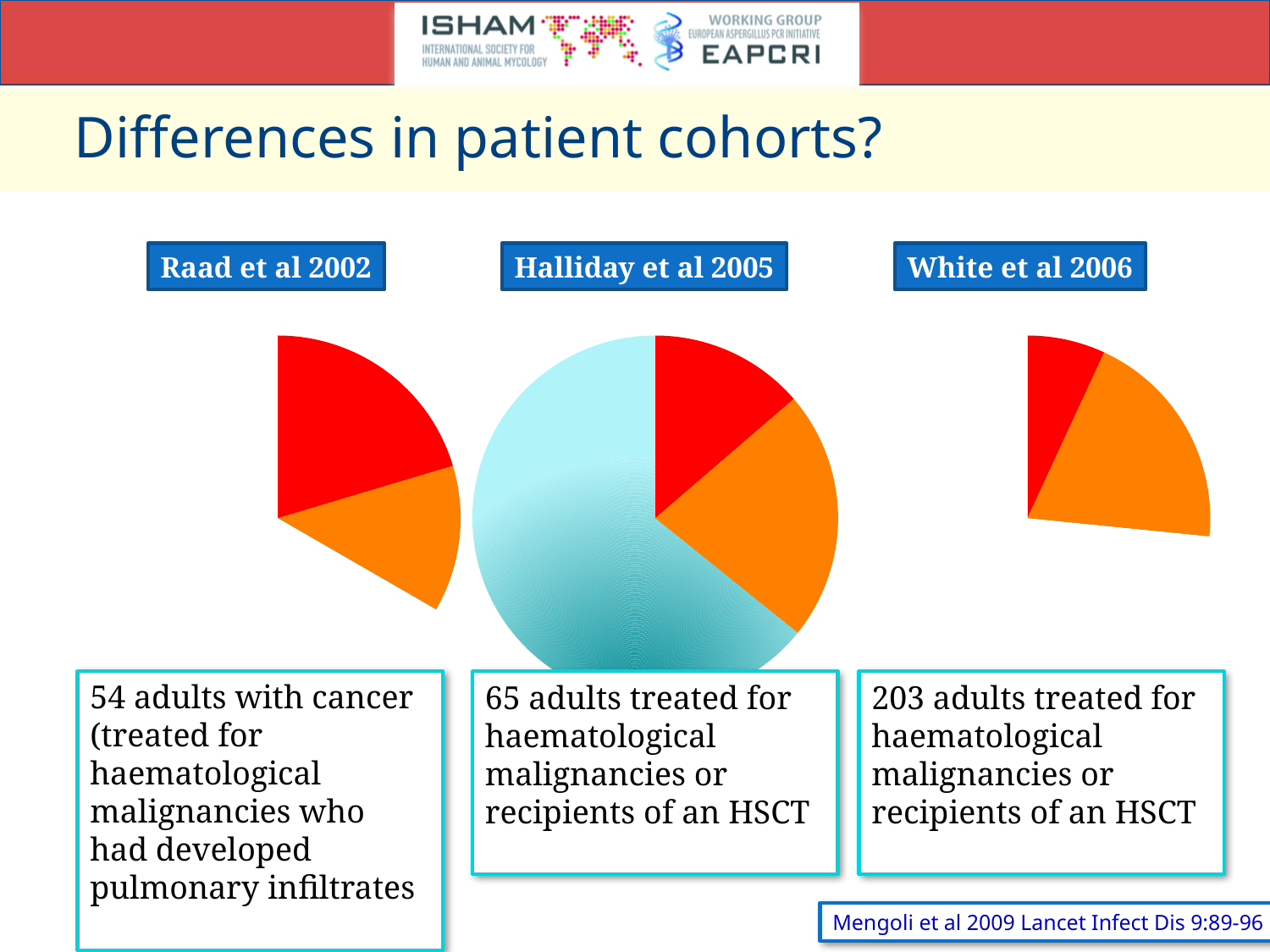
How many slices does the 'Halliday et al 2005' pie chart have? 3 In the 'Halliday et al 2005' pie chart, which colour slice is the largest? light blue How many pie charts are shown on the slide? 3 According to the text box under the 'Halliday et al 2005' pie chart, how many adults were in that cohort? 65 In the 'Halliday et al 2005' pie chart, which colour slice is the smallest? red How many coloured slices are shown in the 'Raad et al 2002' pie chart? 2 In the 'White et al 2006' pie chart, which colour slice is the smallest? red What kind of chart is shown under the 'Halliday et al 2005' label? pie chart In the 'White et al 2006' pie chart, is the orange slice or the red slice larger? orange In the 'Raad et al 2002' pie chart, is the red slice or the orange slice larger? red In the 'Halliday et al 2005' pie chart, is the orange slice or the red slice larger? orange